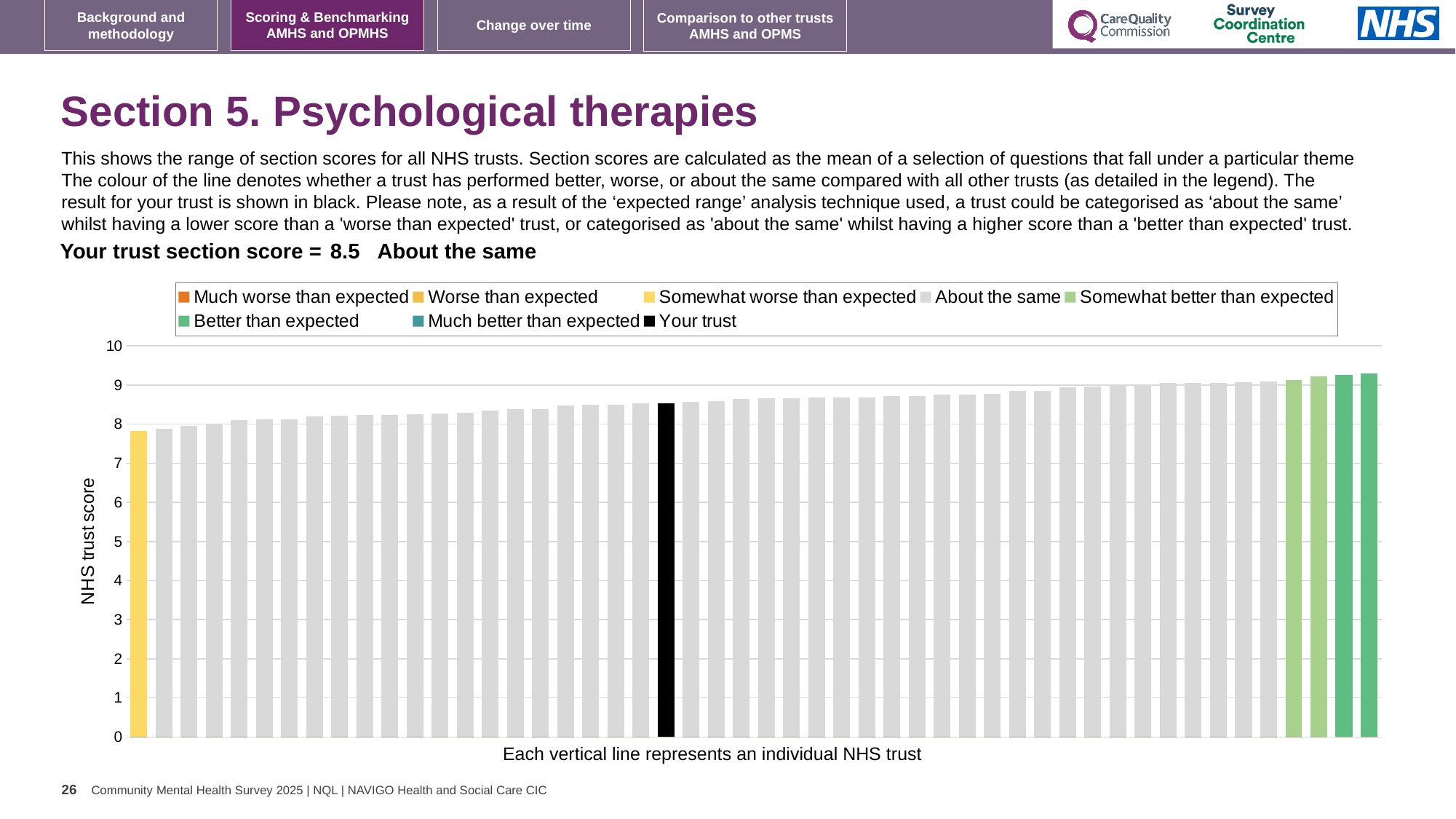
How many entries does the chart legend list? 8 Which category is your trust placed in for this section? About the same Is the value of the rightmost bar greater or less than 9? greater What is the label on the vertical axis of the chart? NHS trust score What is the section score for your trust shown on the slide? 8.5 Which bar is the lowest: the leftmost yellow bar or the black 'Your trust' bar? the leftmost yellow bar Is the value of the black 'Your trust' bar greater or less than 8? greater Is the value of the leftmost bar greater or less than 9? less What colour is the bar representing your trust? black Do the bar values rise or fall from left to right across the chart? rise What kind of chart is shown on the slide? bar chart